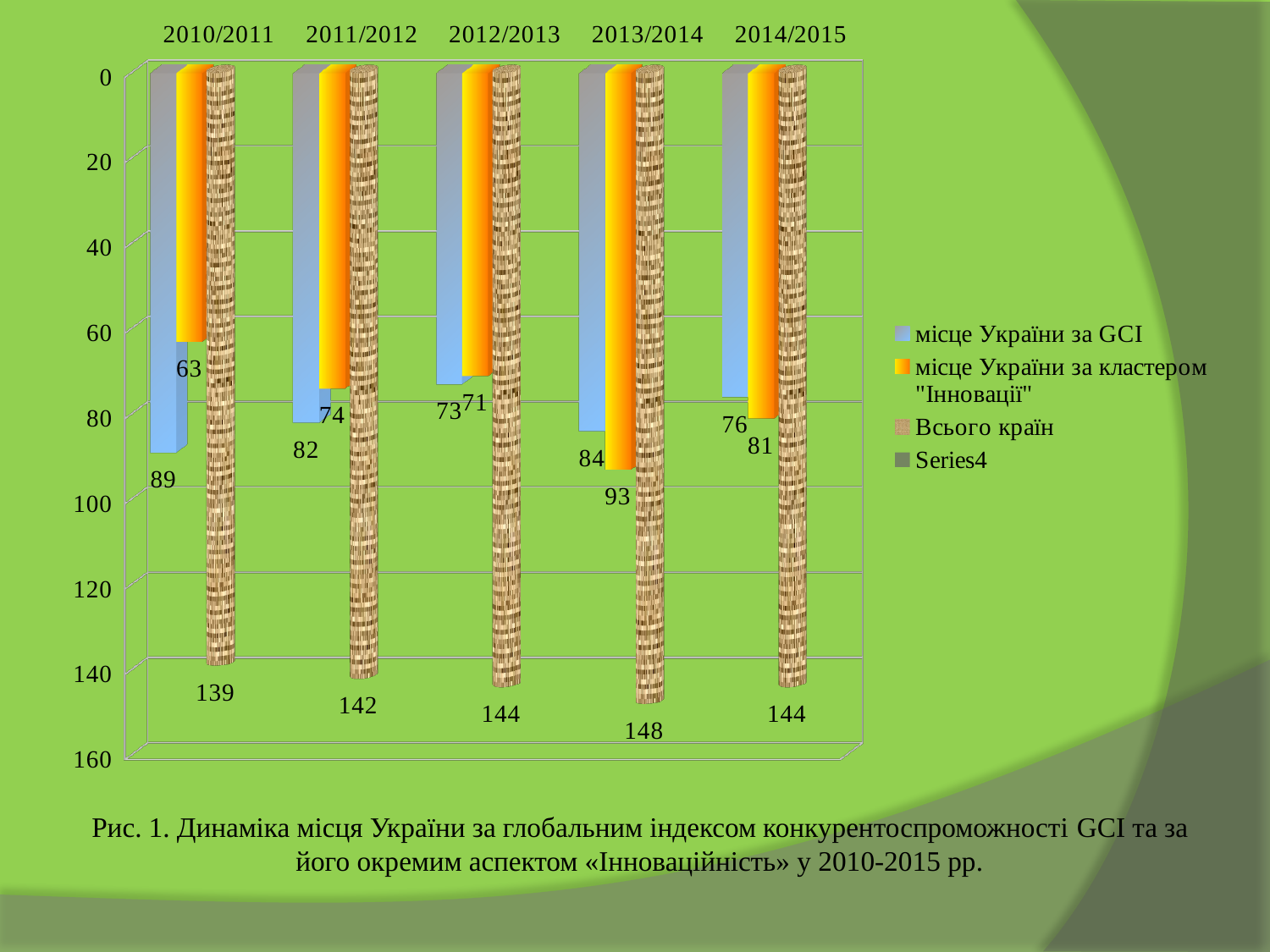
How many series does the legend list? 4 What is the name of the fourth legend entry? Series4 What is the value for "Всього країн" in 2012/2013? 144 In which year is the value for "Всього країн" the highest? 2013/2014 How many year categories are shown on the x axis? 5 In which year is the value for "місце України за GCI" the lowest? 2012/2013 What is the value for "місце України за кластером "Інновації"" in 2013/2014? 93 What is the value for "місце України за GCI" in 2010/2011? 89 What is the difference between "місце України за GCI" and "місце України за кластером "Інновації"" in 2010/2011? 26 Which is larger in 2014/2015: "місце України за GCI" or "місце України за кластером "Інновації""? місце України за кластером "Інновації" What kind of chart is shown on the slide? bar chart Does the value for "місце України за кластером "Інновації"" rise or fall from 2012/2013 to 2013/2014? rise